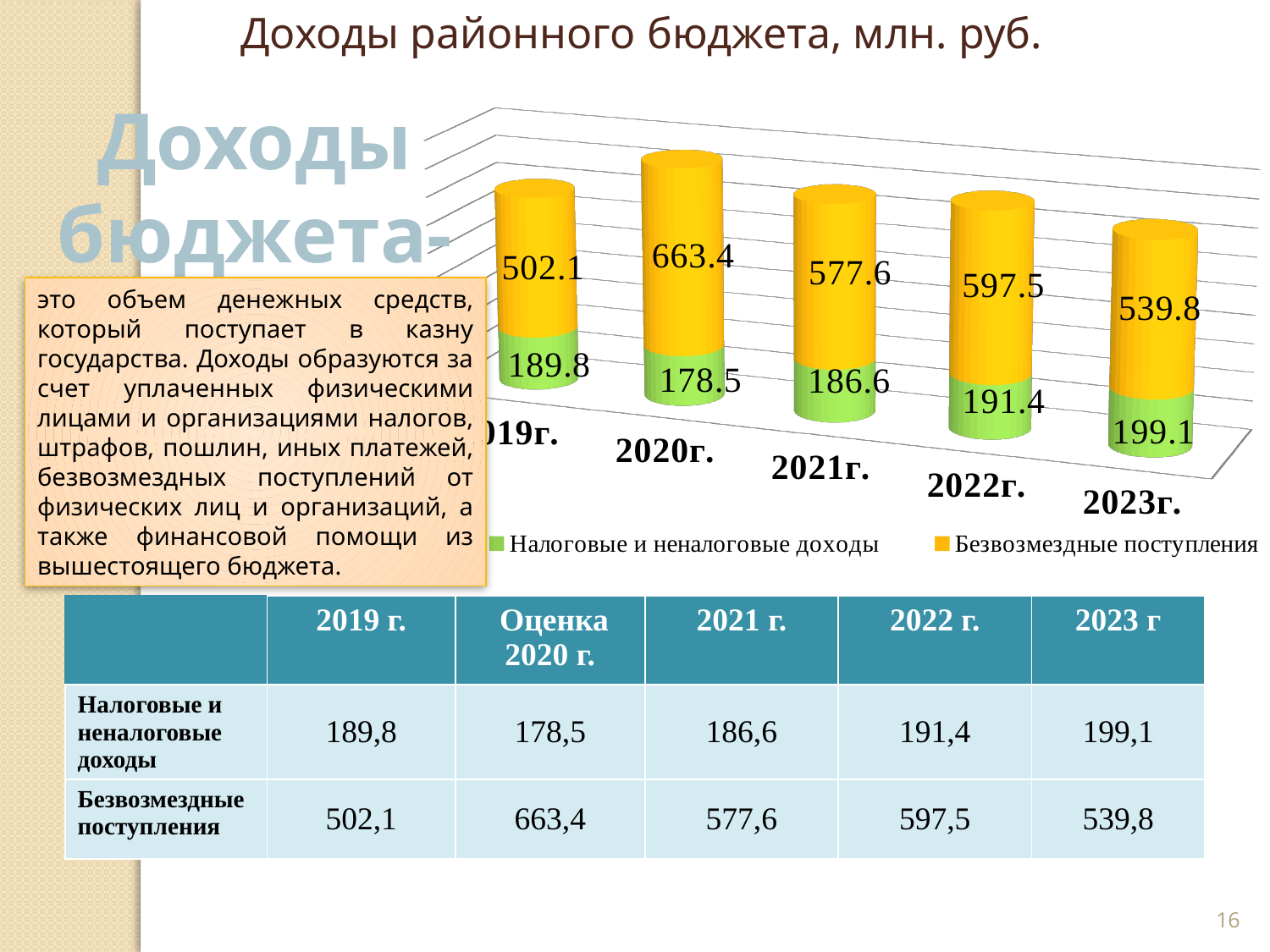
What is the difference between Безвозмездные поступления in 2020г. and 2019г.? 161.3 Which colour represents Безвозмездные поступления in the chart? Yellow What is the value of Безвозмездные поступления for 2020г.? 663.4 What type of chart is shown on the slide? Stacked bar chart How many years (categories) are shown on the chart's x axis? 5 Do the values of Налоговые и неналоговые доходы rise or fall from 2020г. to 2023г.? Rise What is the total of the stacked bar for 2019г.? 691.9 Which is larger: Безвозмездные поступления in 2021г. or in 2022г.? 2022г. How many series does the chart legend list? 2 In which year is Налоговые и неналоговые доходы the lowest? 2020г. What is the value of Налоговые и неналоговые доходы for 2023г.? 199.1 In which year is Безвозмездные поступления the highest? 2020г.